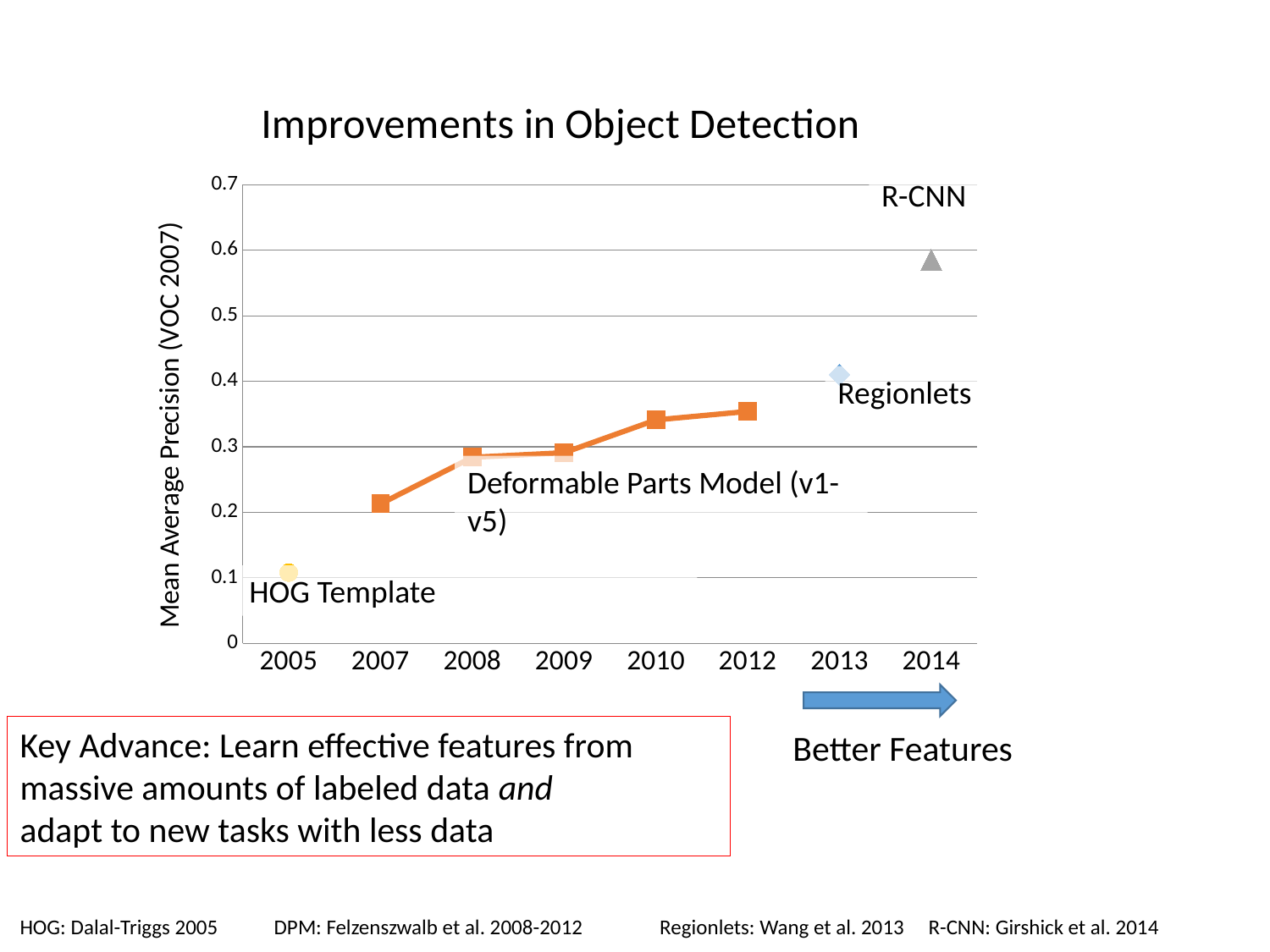
Which is larger, the value for 2012 or the value for 2013? 2013 Do the values generally rise or fall from 2005 to 2014? rise How many years are shown on the x axis? 8 What kind of chart is shown on the slide? line chart Is the value for Regionlets in 2013 greater or less than 0.5? less Is the value for R-CNN in 2014 greater or less than 0.5? greater Is the value for 2007 greater or less than 0.3? less Which year has the highest mean average precision? 2014 What is the title of the chart? Improvements in Object Detection What is the label of the y axis? Mean Average Precision (VOC 2007) Which year has the lowest mean average precision? 2005